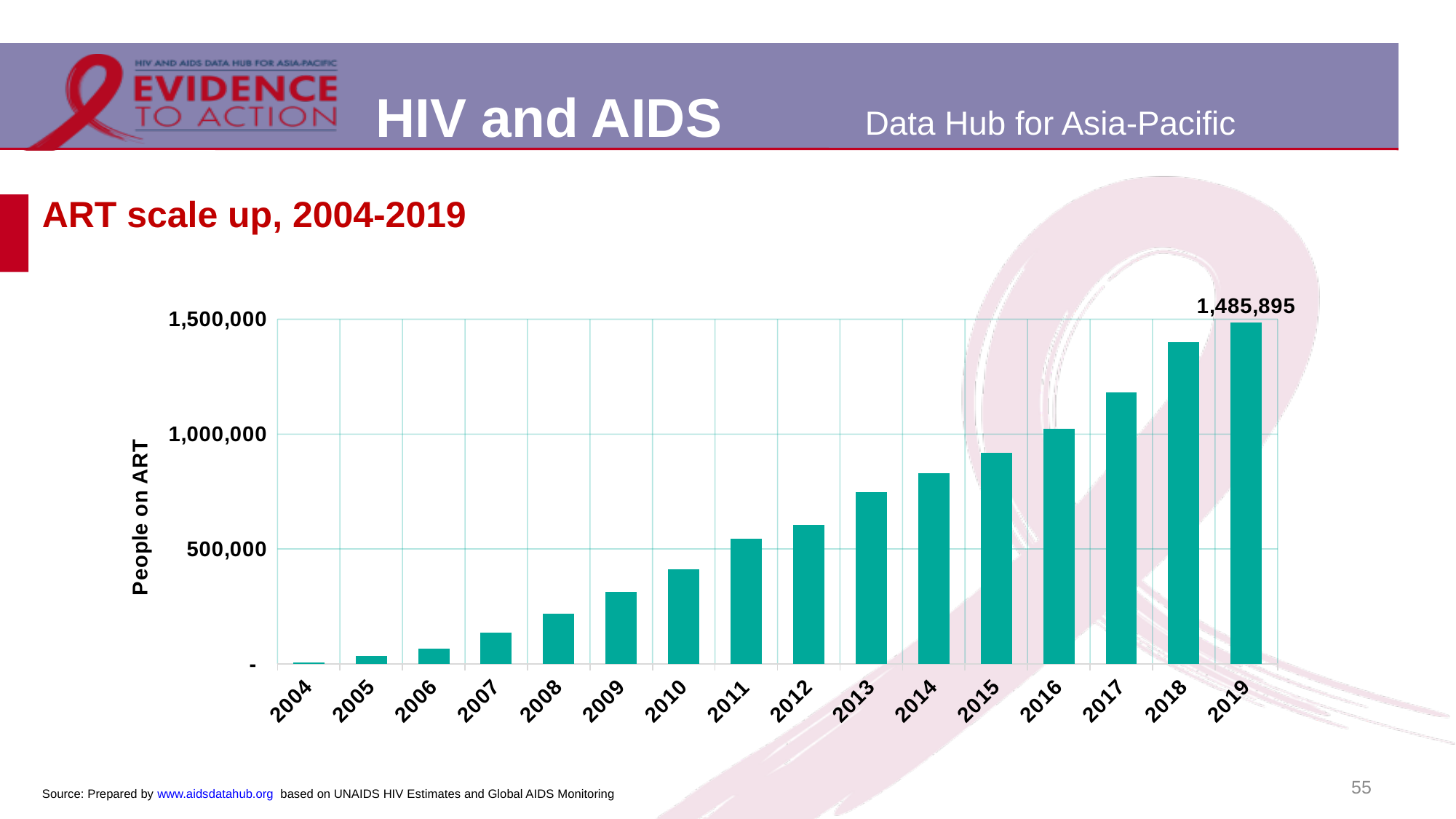
Which year has the highest number of people on ART? 2019 Is the value for 2011 greater or less than 500,000? greater What is the label of the y axis of the chart? People on ART What is the value for 2019 in the ART scale up chart? 1,485,895 Is the value for 2016 greater or less than 1,000,000? greater Do the values rise or fall from 2004 to 2019? Rise How many years are shown on the x axis of the chart? 16 What kind of chart is shown on the slide? Bar chart Is the value for 2018 greater or less than 1,500,000? less Which year has the lowest number of people on ART? 2004 Which year has a larger value, 2013 or 2009? 2013